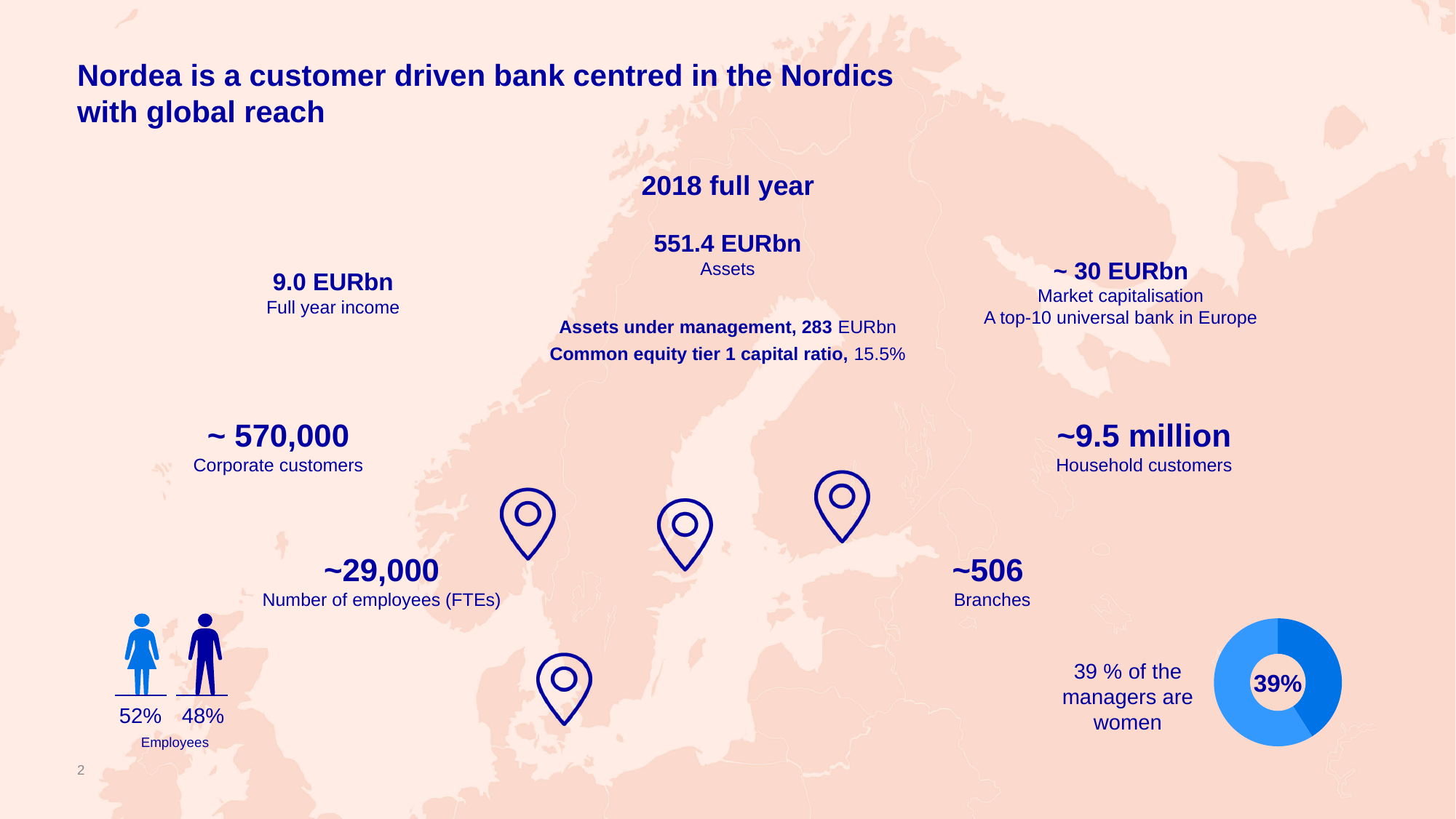
What kind of chart is shown in the bottom right corner of the slide? Donut (pie) chart What does the donut chart on the slide represent? 39 % of the managers are women Is the share of managers who are women shown in the donut chart greater or less than 50%? less How many slices does the donut chart have? 2 What share of the donut chart is not accounted for by the 39% women managers slice? 61% According to the donut chart, what share of managers are women? 39% In the donut chart, which slice is larger: the slice for women managers or the remaining slice? The remaining slice What percentage is printed in the centre of the donut chart? 39%